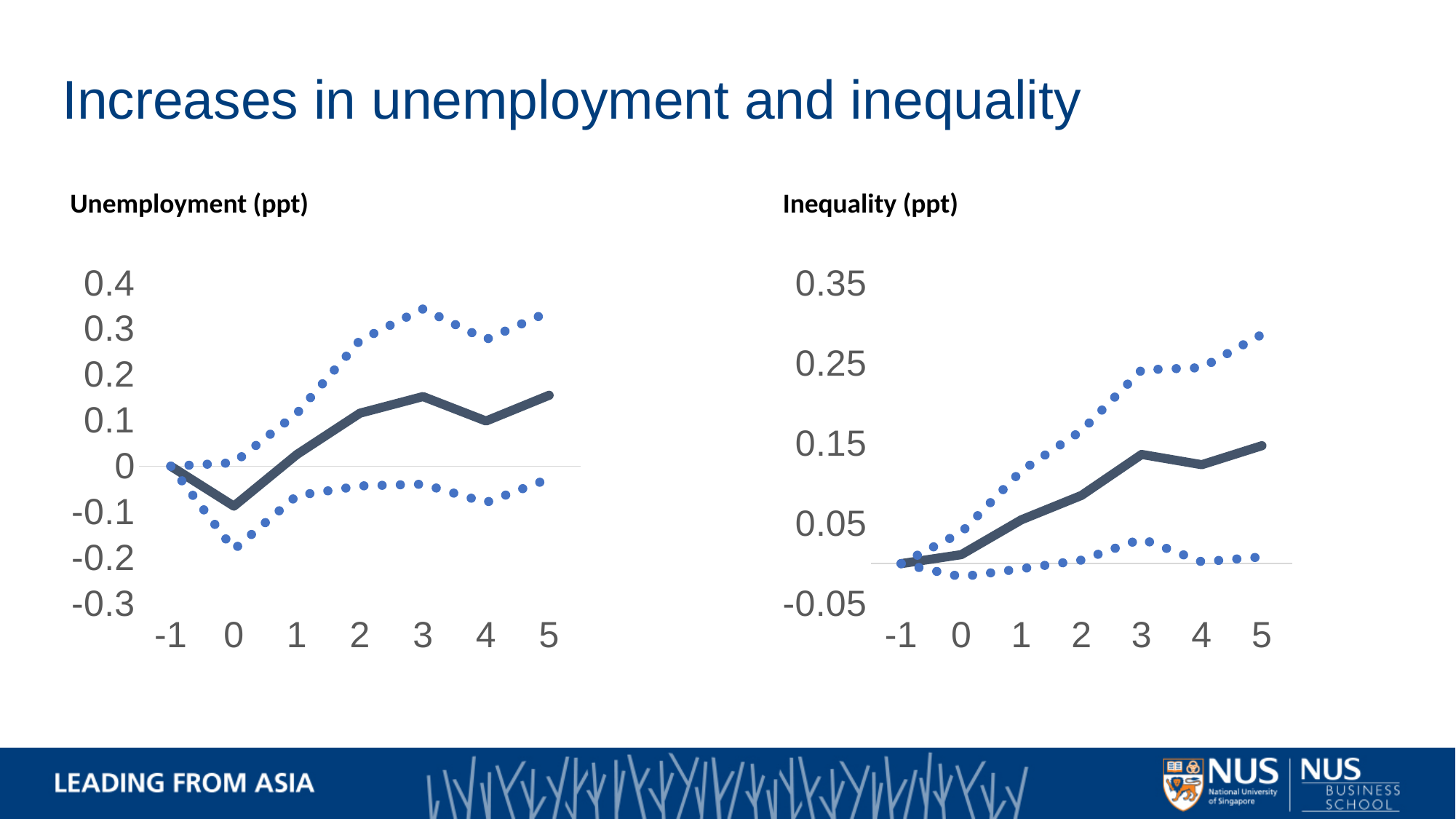
In the Unemployment (ppt) chart, at which x value is the solid line lowest? 0 What kind of chart is the Unemployment (ppt) chart? line chart In the Inequality (ppt) chart, is the solid line value higher at x = 1 or at x = 3? 3 In the Inequality (ppt) chart, what is the value of the solid line at x = -1? 0 In the Unemployment (ppt) chart, is the solid line value higher at x = 3 or at x = 4? 3 How many points are on the x axis of the Inequality (ppt) chart? 7 In the Unemployment (ppt) chart, is the solid line value at x = 0 greater or less than 0? less In the Inequality (ppt) chart, is the solid line value at x = 5 greater or less than 0.1? greater In the Inequality (ppt) chart, does the solid line generally rise or fall from x = -1 to x = 5? rise In the Unemployment (ppt) chart, what is the value of the solid line at x = -1? 0 In the Unemployment (ppt) chart, is the solid line value at x = 3 greater or less than 0.1? greater